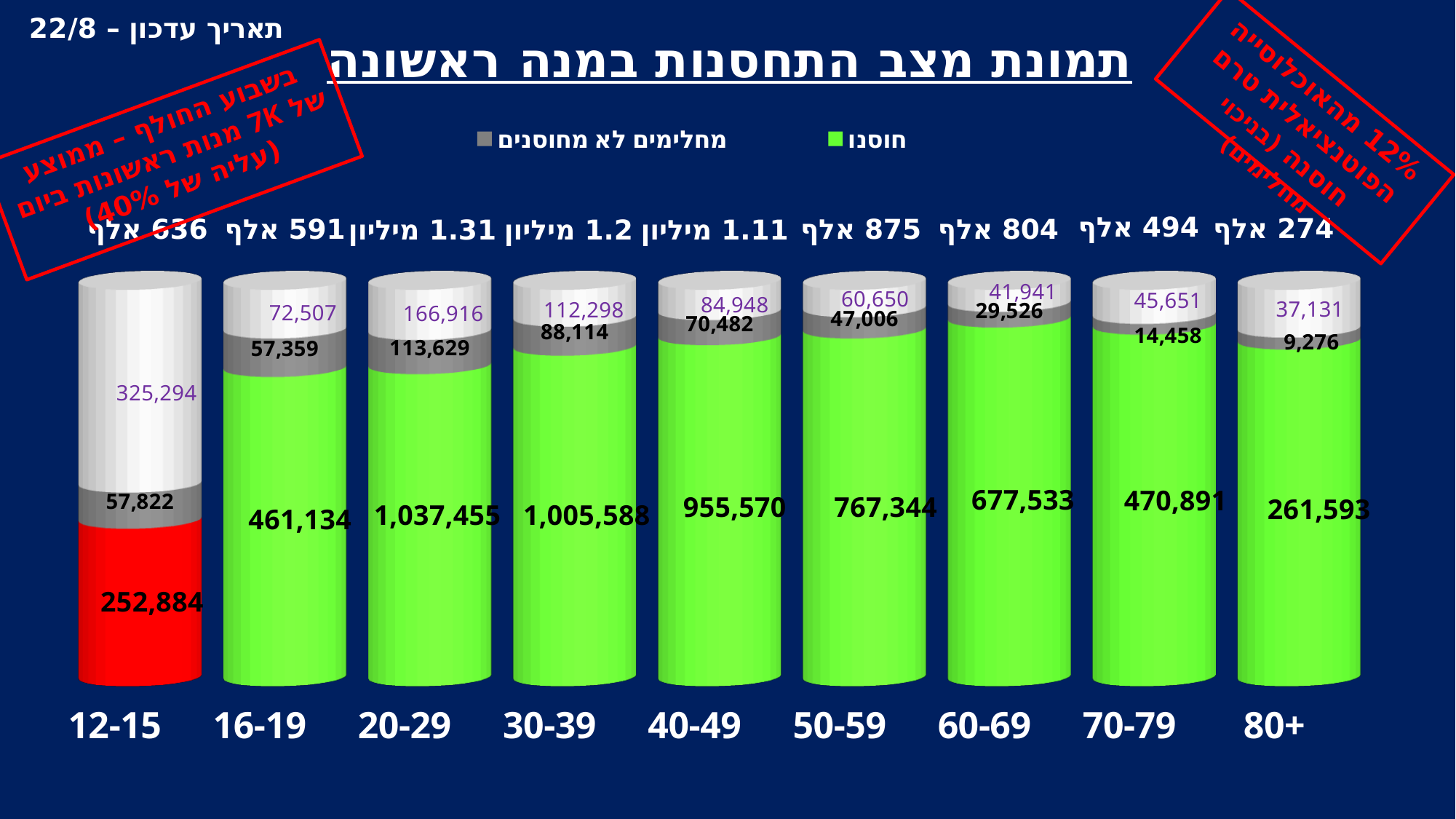
What is the difference between the vaccinated values for the 40-49 and 50-59 age groups? 188,226 What is the recovered-not-vaccinated (מחלימים לא מחוסנים) value for the 30-39 age group? 88,114 What is the vaccinated (חוסנו) value for the 20-29 age group? 1,037,455 What is the value shown in the red segment for the 12-15 age group? 252,884 What total is printed above the 30-39 bar? 1.2 מיליון Which age group has the highest vaccinated (חוסנו) value? 20-29 How many series does the legend list? 2 What colour represents the חוסנו (vaccinated) series in the legend? Green How many age groups are shown on the x axis? 9 What kind of chart is shown on the slide? Stacked bar chart Which age group has the lowest recovered-not-vaccinated (מחלימים לא מחוסנים) value? 80+ Which is larger: the vaccinated value for 16-19 or for 70-79? 70-79